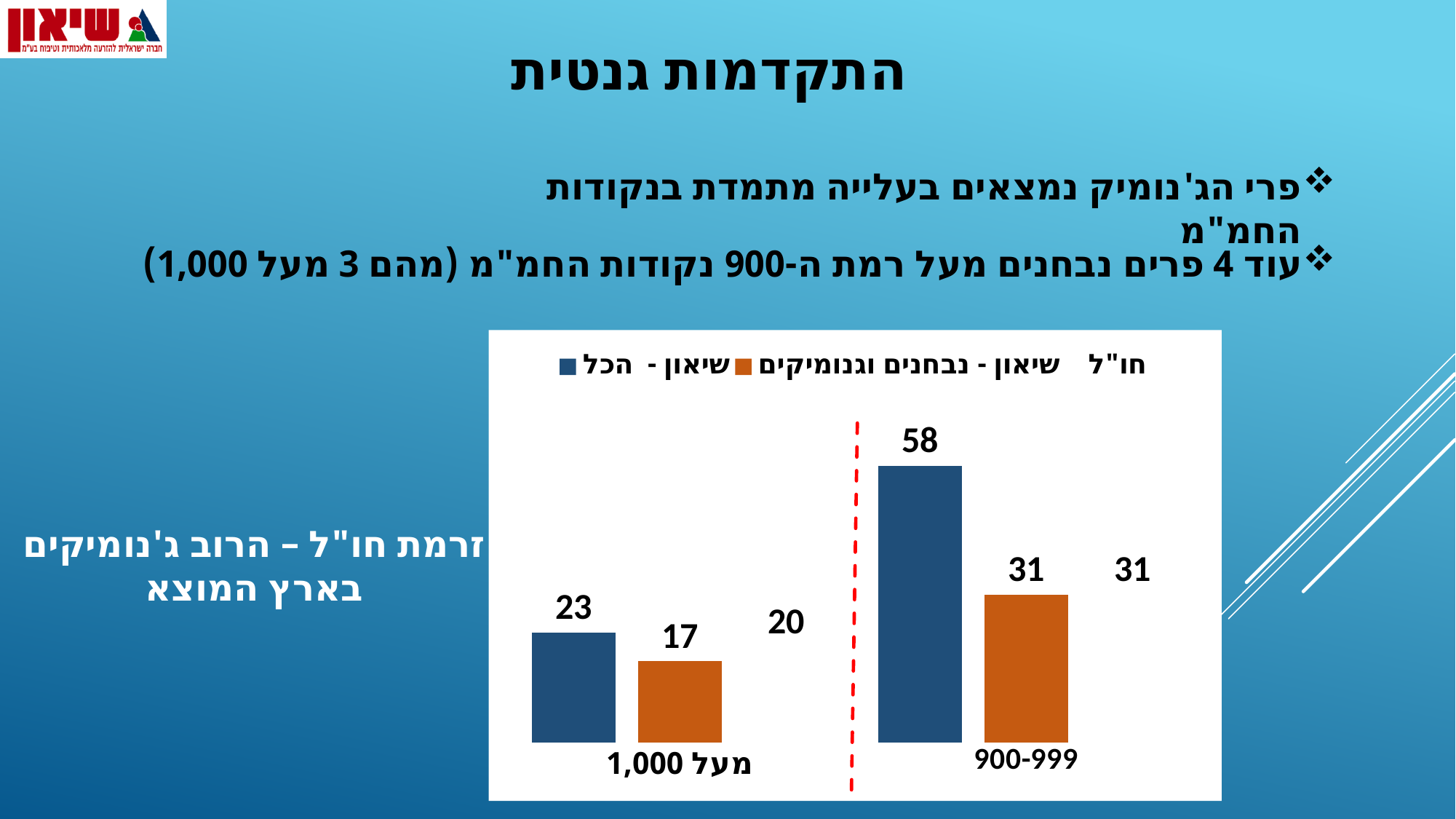
What is the value of the 'שיאון - הכל' series for the '900-999' category? 58 What is the difference between the 'שיאון - הכל' and 'שיאון - נבחנים וגנומיקים' values in the '900-999' category? 27 What is the value labelled for 'חו"ל' in the 'מעל 1,000' category? 20 What is the value of the 'שיאון - נבחנים וגנומיקים' series for the 'מעל 1,000' category? 17 What is the difference between the 'שיאון - הכל' values for '900-999' and 'מעל 1,000'? 35 What is the value of the 'שיאון - נבחנים וגנומיקים' series for the '900-999' category? 31 Which category has the highest value for the 'שיאון - הכל' series? 900-999 In the 'מעל 1,000' category, which is larger: 'שיאון - הכל' or 'שיאון - נבחנים וגנומיקים'? שיאון - הכל How many categories are shown on the x axis of the chart? 2 What type of chart is shown on the slide? bar chart How many series does the chart legend list? 3 What is the value of the 'שיאון - הכל' series for the 'מעל 1,000' category? 23